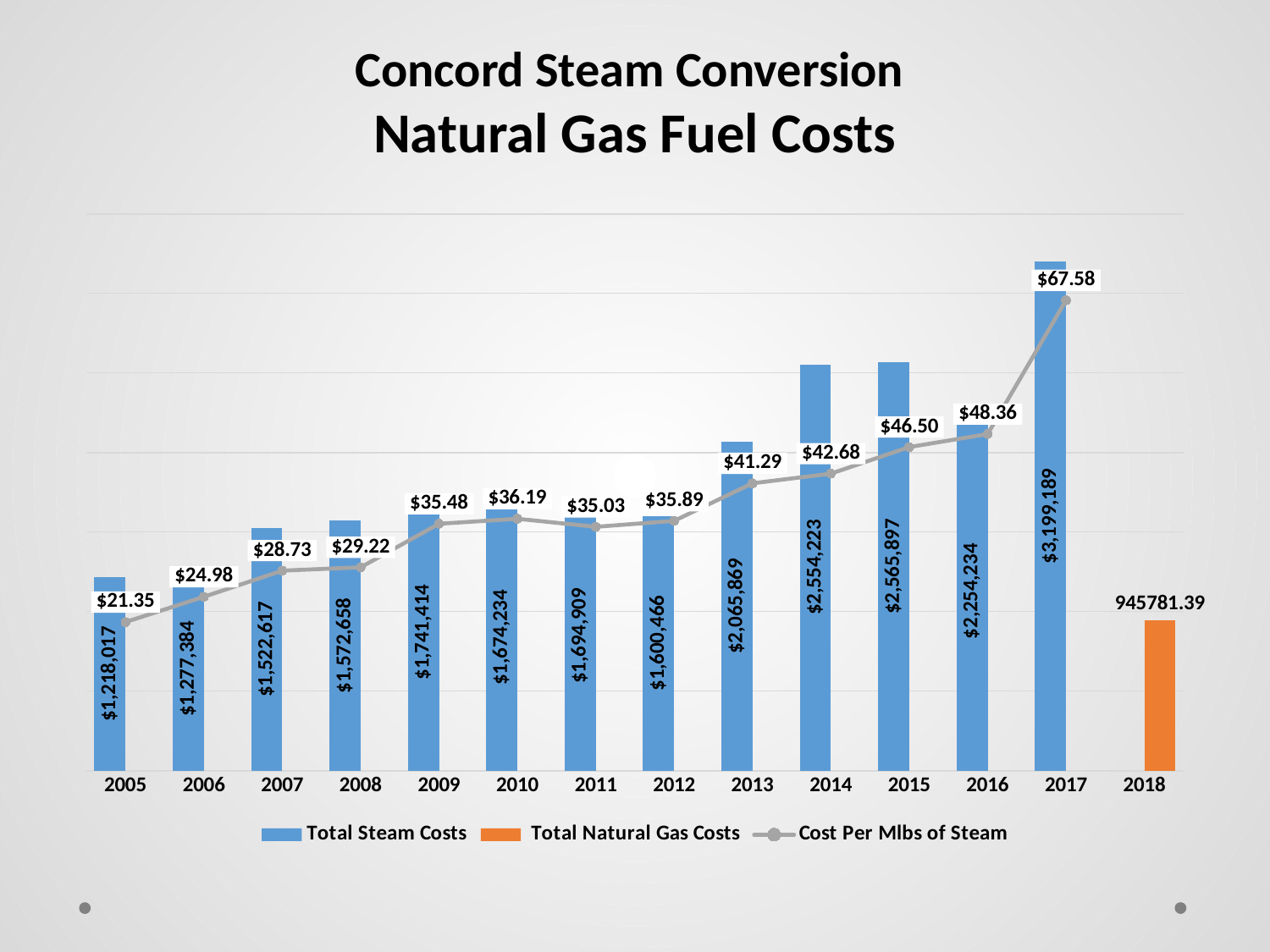
What is the Total Natural Gas Costs value shown for 2018? 945781.39 What is the difference in Total Steam Costs between 2017 and 2016? $944,955 What is the Total Steam Costs value for 2013? $2,065,869 What kind of chart is this? Combination bar and line chart What is the Cost Per Mlbs of Steam for 2009? $35.48 Which year has the highest Total Steam Costs? 2017 Which year has the lowest Total Steam Costs? 2005 Which year has the lowest Cost Per Mlbs of Steam? 2005 By how much did the Cost Per Mlbs of Steam increase from 2016 to 2017? $19.22 Which year had higher Total Steam Costs, 2010 or 2011? 2011 How many series does the legend list? 3 How many years are shown on the x axis? 14